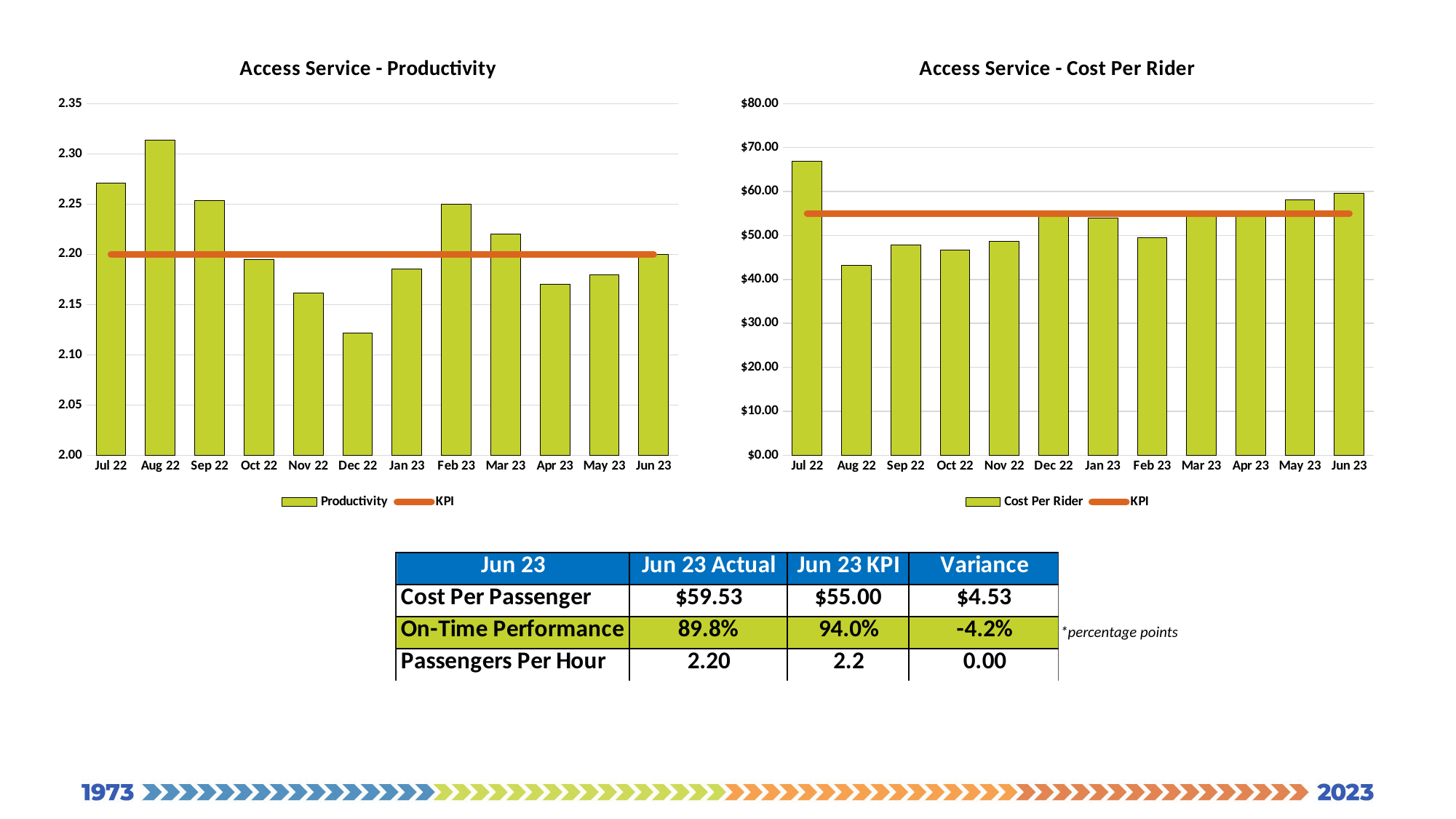
In the "Access Service - Cost Per Rider" chart, which is larger, the cost per rider for Jul 22 or for Jun 23? Jul 22 In the "Access Service - Productivity" chart, how many months are shown on the x axis? 12 What kind of chart is the "Access Service - Productivity" chart? combination bar and line chart How many series does the legend of the "Access Service - Cost Per Rider" chart list? 2 In the "Access Service - Productivity" chart, which month has the lowest productivity bar? Dec 22 In the "Access Service - Productivity" chart, is the value for Dec 22 greater or less than 2.15? less In the "Access Service - Cost Per Rider" chart, which month has the highest cost per rider? Jul 22 In the "Access Service - Cost Per Rider" chart, is the value for Jul 22 greater or less than $60.00? greater In the "Access Service - Productivity" chart, what is the productivity value for Jun 23? 2.20 What are the two legend entries of the "Access Service - Cost Per Rider" chart? Cost Per Rider and KPI In the "Access Service - Cost Per Rider" chart, which month has the lowest cost per rider? Aug 22 In the "Access Service - Productivity" chart, which month has the highest productivity bar? Aug 22